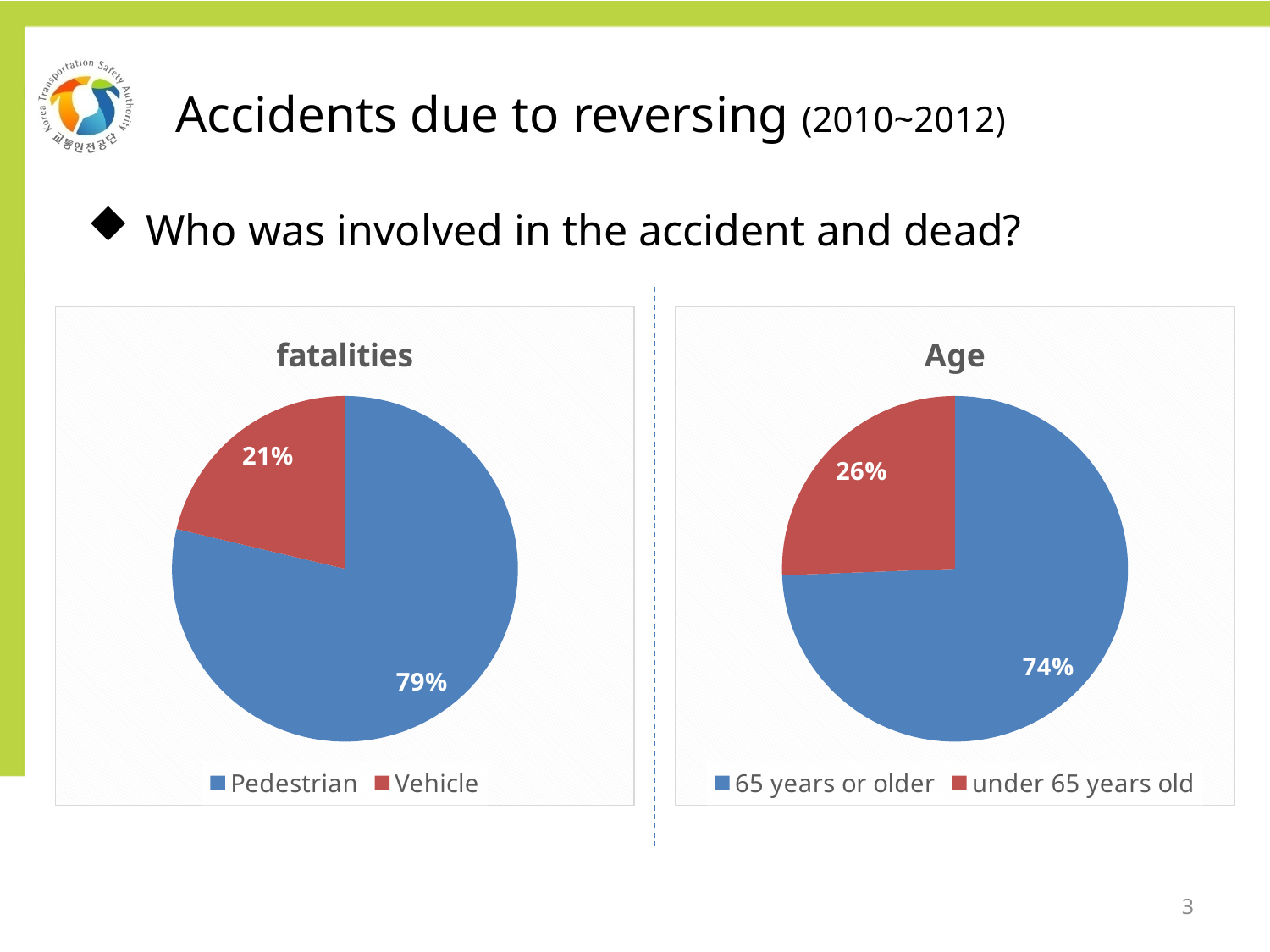
In the "fatalities" chart, which category has the largest slice? Pedestrian In the "fatalities" chart, what share of the pie is Pedestrian? 79% In the "fatalities" chart, what share of the pie is Vehicle? 21% In the "Age" chart, which category has the smallest slice? under 65 years old What colour is the Vehicle slice in the "fatalities" chart? Red In the "Age" chart, what is the difference between the 65 years or older and under 65 years old shares? 48% In the "fatalities" chart, what is the difference between the Pedestrian and Vehicle shares? 58% In the "Age" chart, what share of the pie is 65 years or older? 74% What kind of chart is the "fatalities" chart? Pie chart How many categories does the "Age" chart show? 2 In the "Age" chart, which is larger: 65 years or older, or under 65 years old? 65 years or older